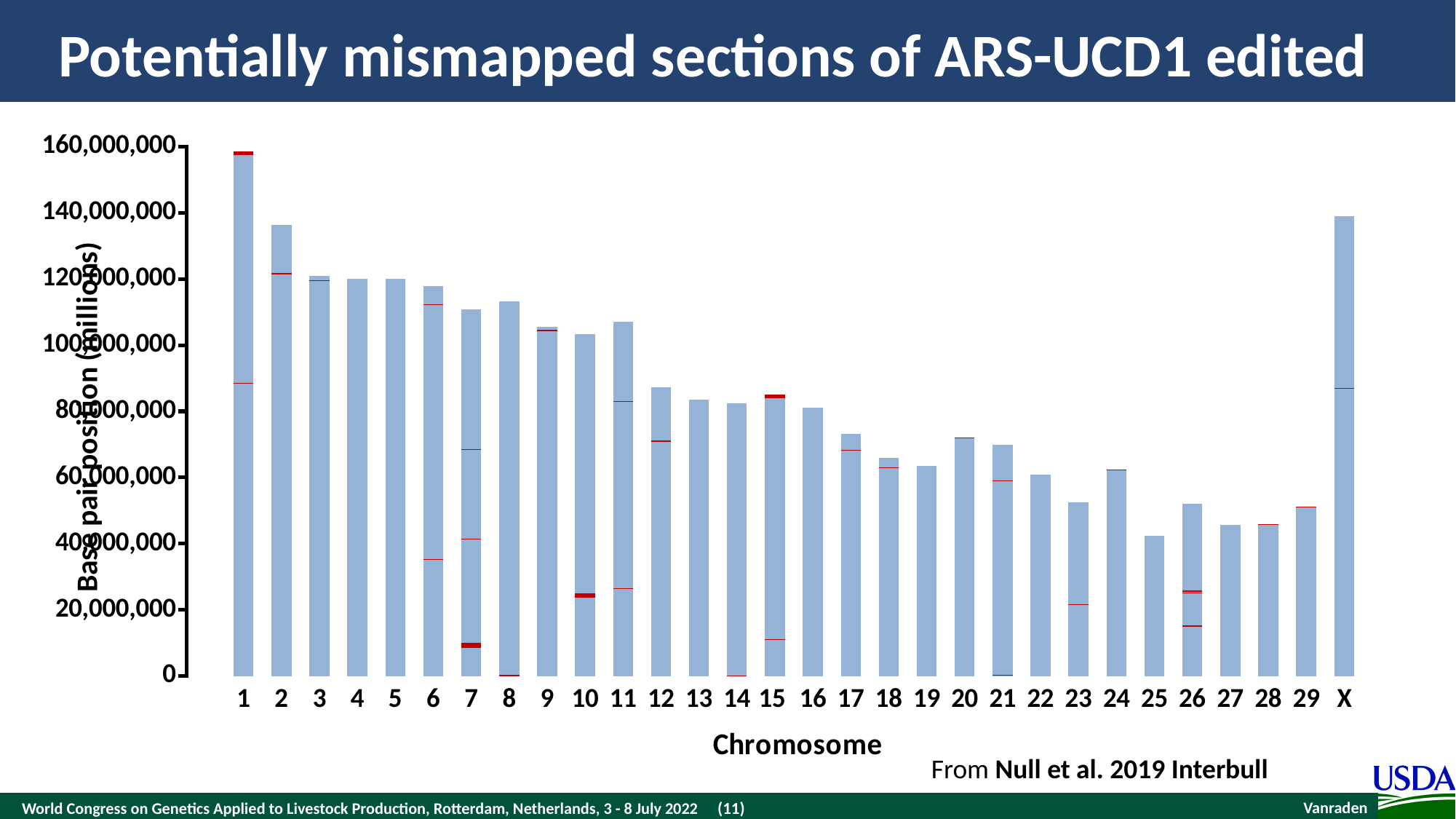
Is the value for chromosome X greater or less than 120,000,000? greater Which chromosome has the lowest base pair position (shortest bar)? 25 Do the bar values generally rise or fall from chromosome 1 to chromosome 29? Fall Is the value for chromosome 1 greater or less than 140,000,000? greater Is the value for chromosome 25 greater or less than 60,000,000? less Which has the larger value, chromosome 24 or chromosome 25? Chromosome 24 How many chromosomes are plotted along the x axis? 30 Which chromosome has the highest base pair position (longest bar)? 1 Which has the larger value, chromosome 1 or chromosome X? Chromosome 1 What is the label of the y axis? Base pair position (millions) What kind of chart is shown on the slide? Bar chart